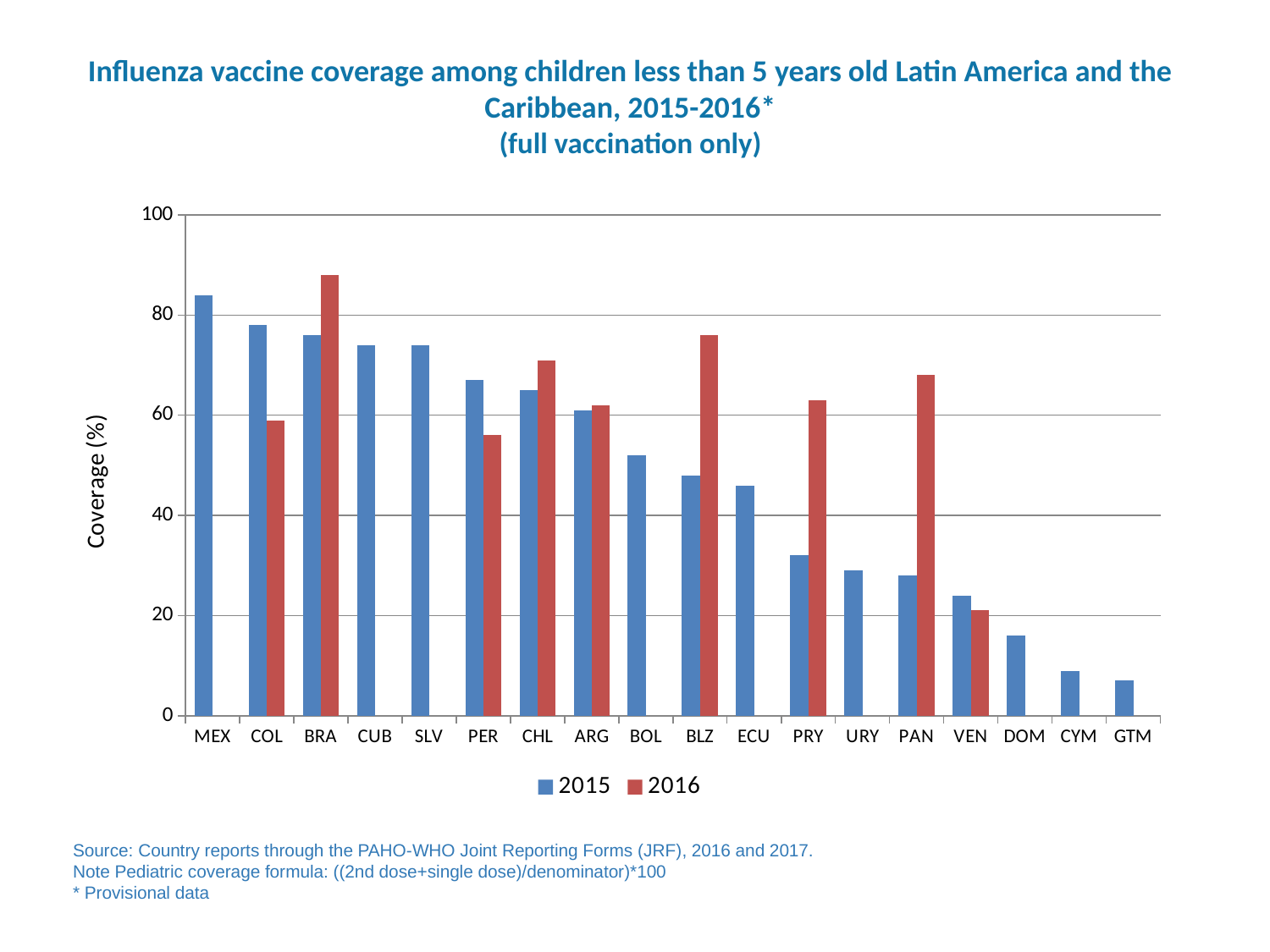
Is the 2015 coverage for PRY greater or less than 40? less Among the countries with a 2016 bar, which has the lowest 2016 coverage? VEN How many series does the legend list? 2 Which country has the highest 2016 coverage? BRA What kind of chart is shown on the slide? Bar chart For PER, which year has the higher coverage, 2015 or 2016? 2015 Do the 2015 coverage values generally rise or fall from left to right along the x axis? fall Is the 2015 coverage for MEX greater or less than 80? greater For BRA, which year has the higher coverage, 2015 or 2016? 2016 How many countries are shown on the x axis? 18 Which country has the highest 2015 coverage? MEX